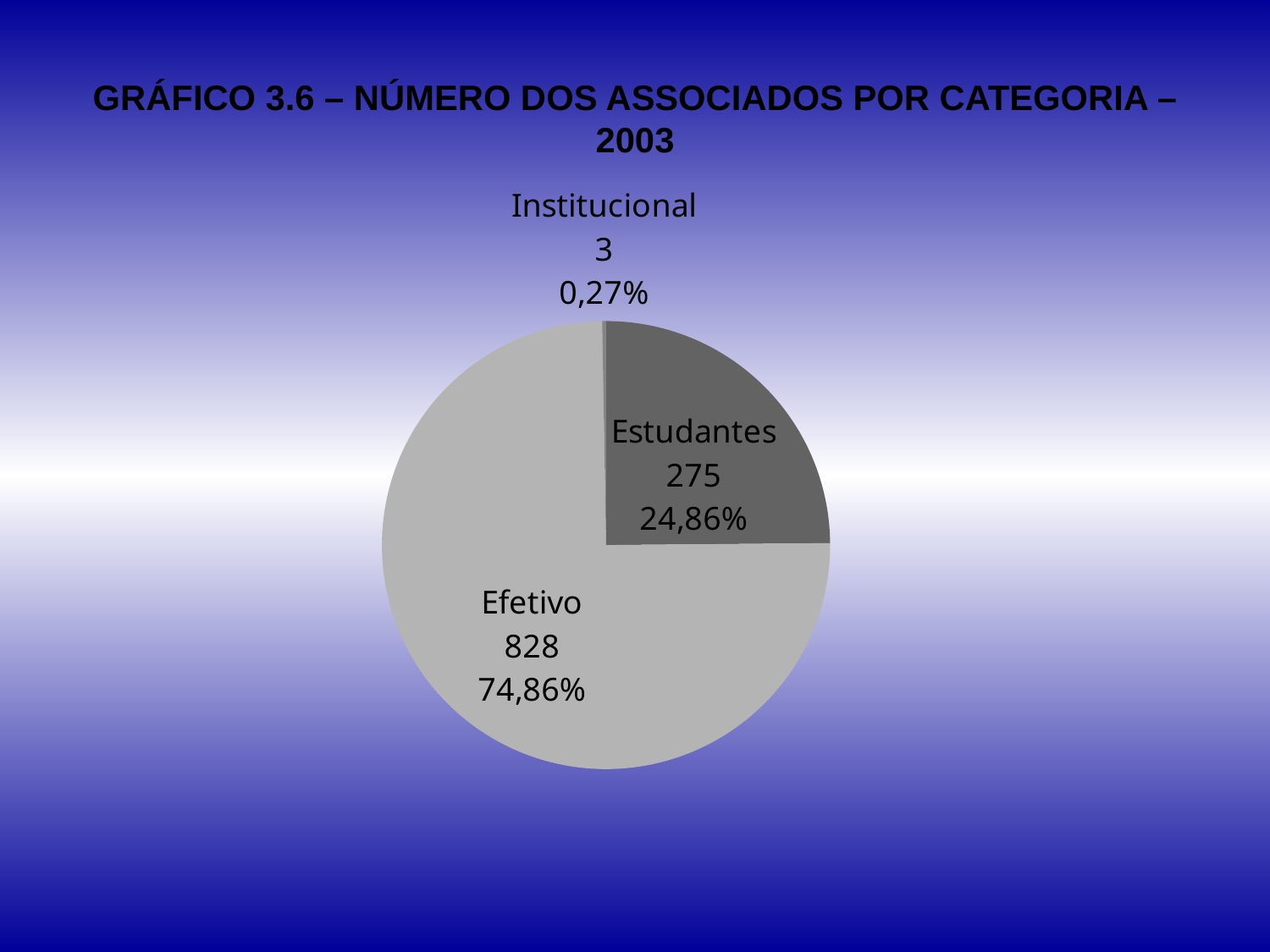
How many categories does the pie chart show? 3 What is the title of the chart? GRÁFICO 3.6 – NÚMERO DOS ASSOCIADOS POR CATEGORIA – 2003 Which category has the smallest number of associates? Institucional What is the number of associates in the Efetivo category? 828 What is the number of associates in the Institucional category? 3 What is the number of associates in the Estudantes category? 275 What share of the pie does the Efetivo slice represent? 74,86% What share of the pie does the Estudantes slice represent? 24,86% What kind of chart is shown on the slide? pie chart What share of the pie does the Institucional slice represent? 0,27% What is the difference between the number of Efetivo associates and Estudantes associates? 553 Which category has the largest number of associates? Efetivo